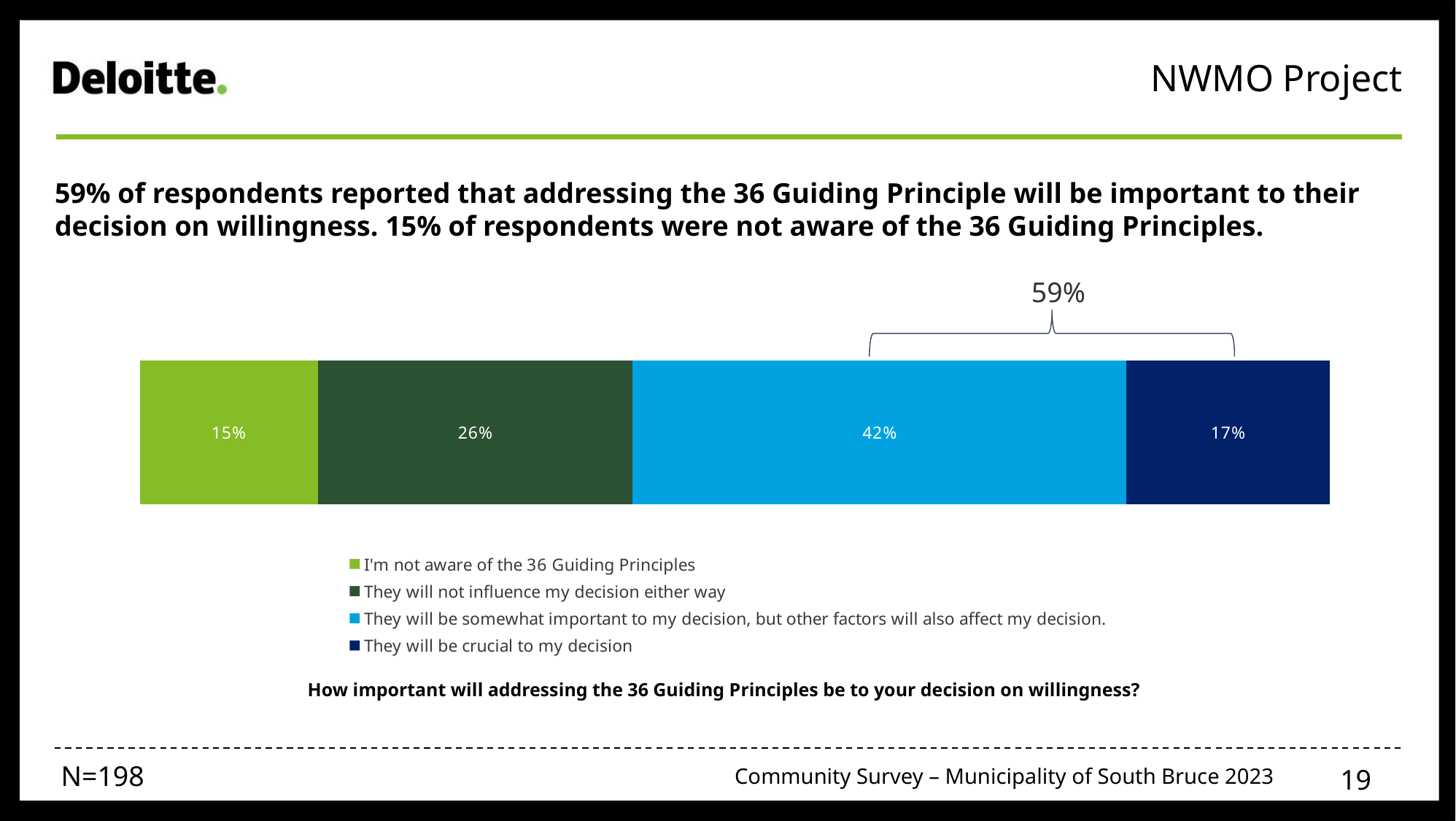
What colour is the segment representing 'They will be crucial to my decision'? Dark blue What combined percentage is shown by the bracket above the bar? 59% What percentage of respondents said the 36 Guiding Principles will not influence their decision either way? 26% How many response categories does the legend list? 4 What percentage of respondents said they are not aware of the 36 Guiding Principles? 15% What percentage of respondents said the 36 Guiding Principles will be crucial to their decision? 17% What is the difference in percentage points between the 'somewhat important' and 'crucial' responses? 25 Which response category has the smallest share of respondents? I'm not aware of the 36 Guiding Principles What type of chart is shown on the slide? Stacked bar chart What percentage of respondents said the 36 Guiding Principles will be somewhat important to their decision? 42% Which is larger: the share saying the principles will not influence their decision, or the share saying they will be crucial? They will not influence my decision either way Which response category has the largest share of respondents? They will be somewhat important to my decision, but other factors will also affect my decision.